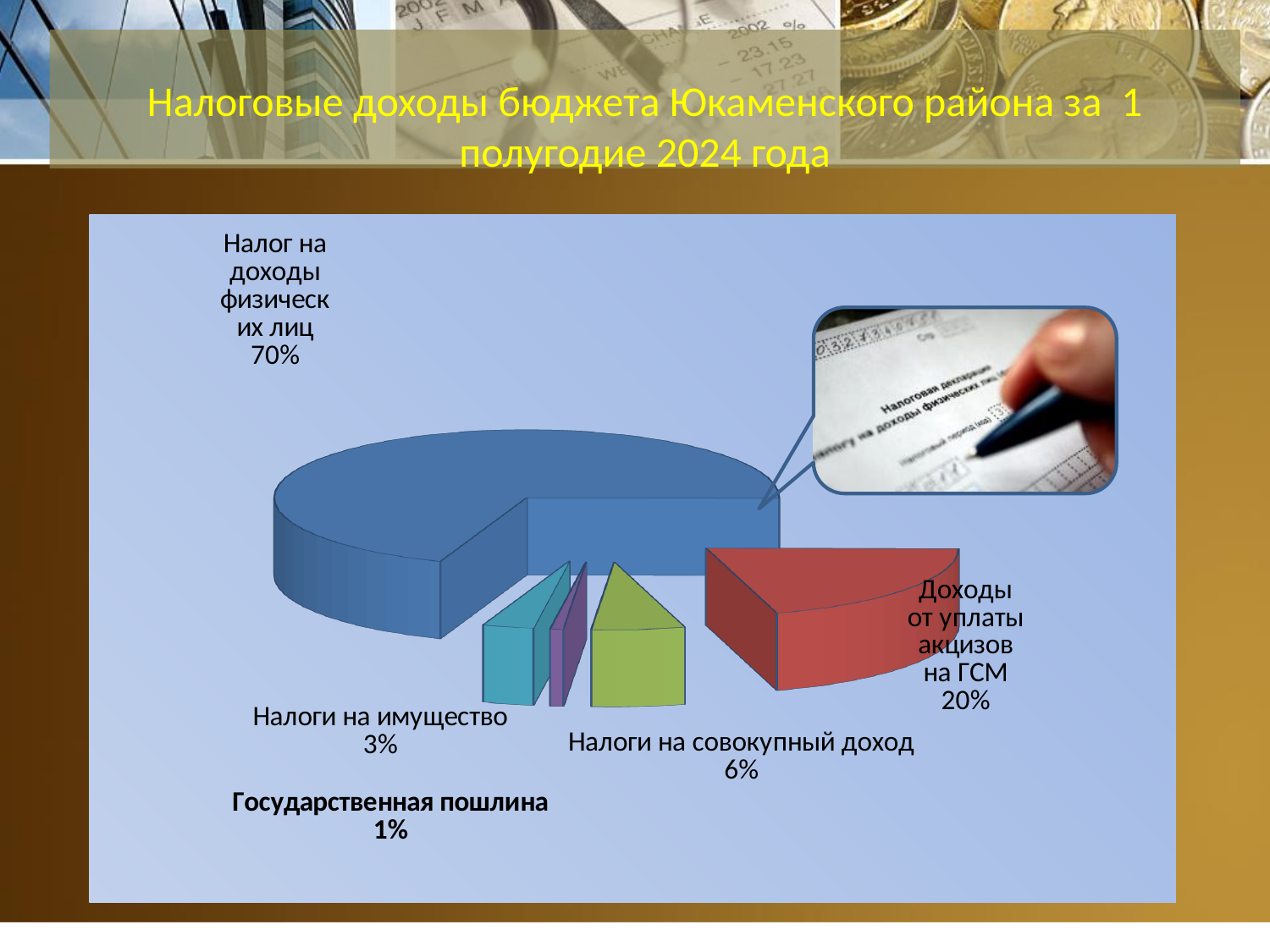
What kind of chart is shown on the slide? Pie chart Which category has the largest share of the pie? Налог на доходы физических лиц Which category has the smallest share of the pie? Государственная пошлина What share of the pie does "Налоги на имущество" have? 3% How many slices does the pie chart have? 5 Which is larger: the share for "Налоги на совокупный доход" or the share for "Налоги на имущество"? Налоги на совокупный доход What is the difference in percentage points between "Налог на доходы физических лиц" and "Доходы от уплаты акцизов на ГСМ"? 50 percentage points What share of the pie does "Доходы от уплаты акцизов на ГСМ" have? 20% What share of the pie does "Государственная пошлина" have? 1% What is the title of the slide containing the chart? Налоговые доходы бюджета Юкаменского района за 1 полугодие 2024 года What share of the pie does "Налог на доходы физических лиц" have? 70% What share of the pie does "Налоги на совокупный доход" have? 6%